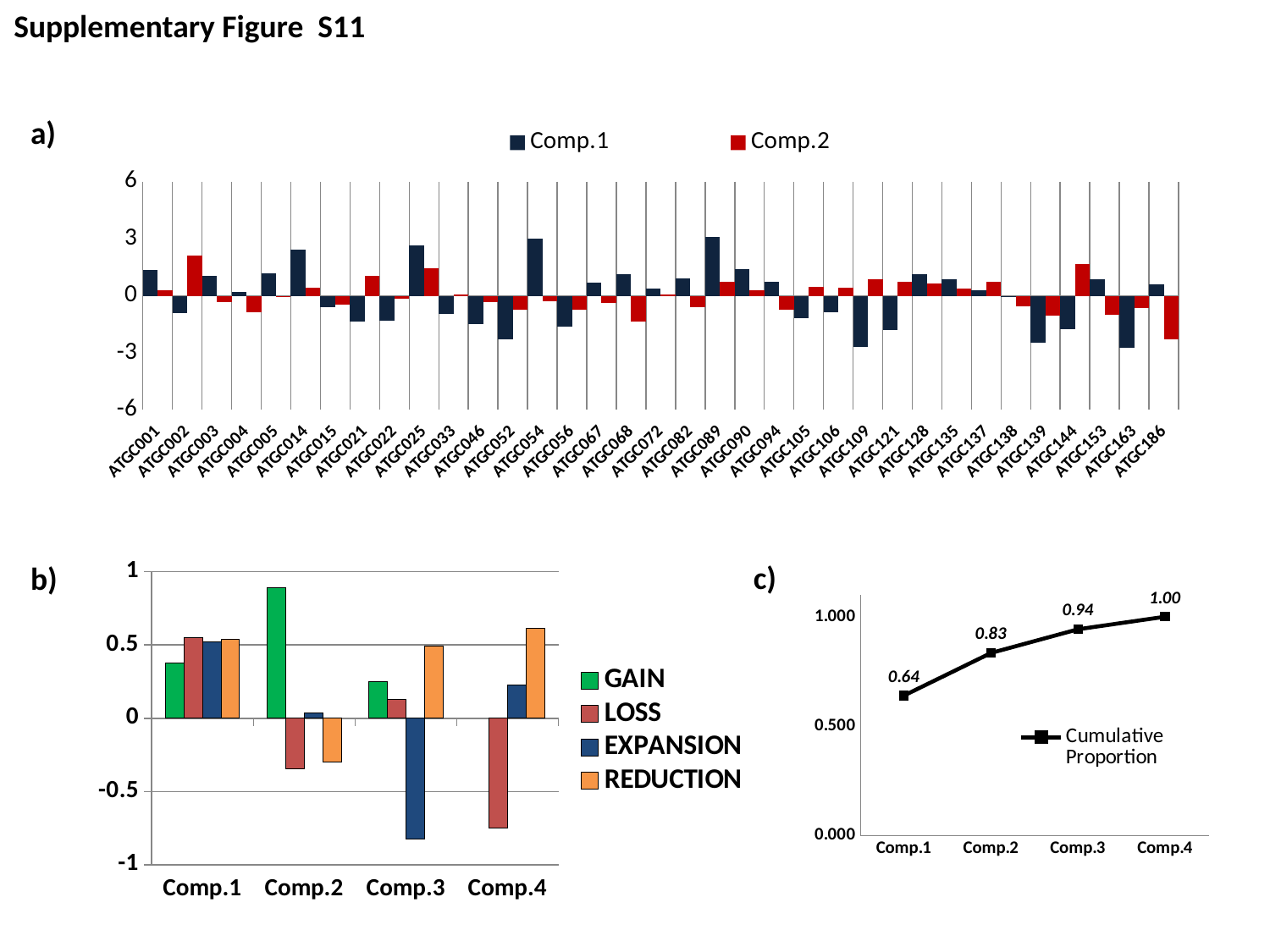
In chart a), how many ATGC categories are shown on the x axis? 35 In chart c), what is the difference between the Cumulative Proportion for Comp.4 and Comp.1? 0.36 In chart c), what is the Cumulative Proportion for Comp.3? 0.94 In chart c), what kind of chart is shown? line chart In chart a), which is larger: the Comp.1 value for ATGC089 or the Comp.1 value for ATGC109? ATGC089 In chart c), which component has the lowest Cumulative Proportion? Comp.1 In chart b), how many series does the legend list? 4 In chart c), does the Cumulative Proportion rise or fall from Comp.1 to Comp.4? rise In chart b), which is larger for Comp.4: the LOSS value or the REDUCTION value? REDUCTION In chart b), is the GAIN value for Comp.2 greater or less than 0.5? greater In chart b), is the EXPANSION value for Comp.3 greater or less than -0.5? less In chart c), what is the Cumulative Proportion for Comp.2? 0.83